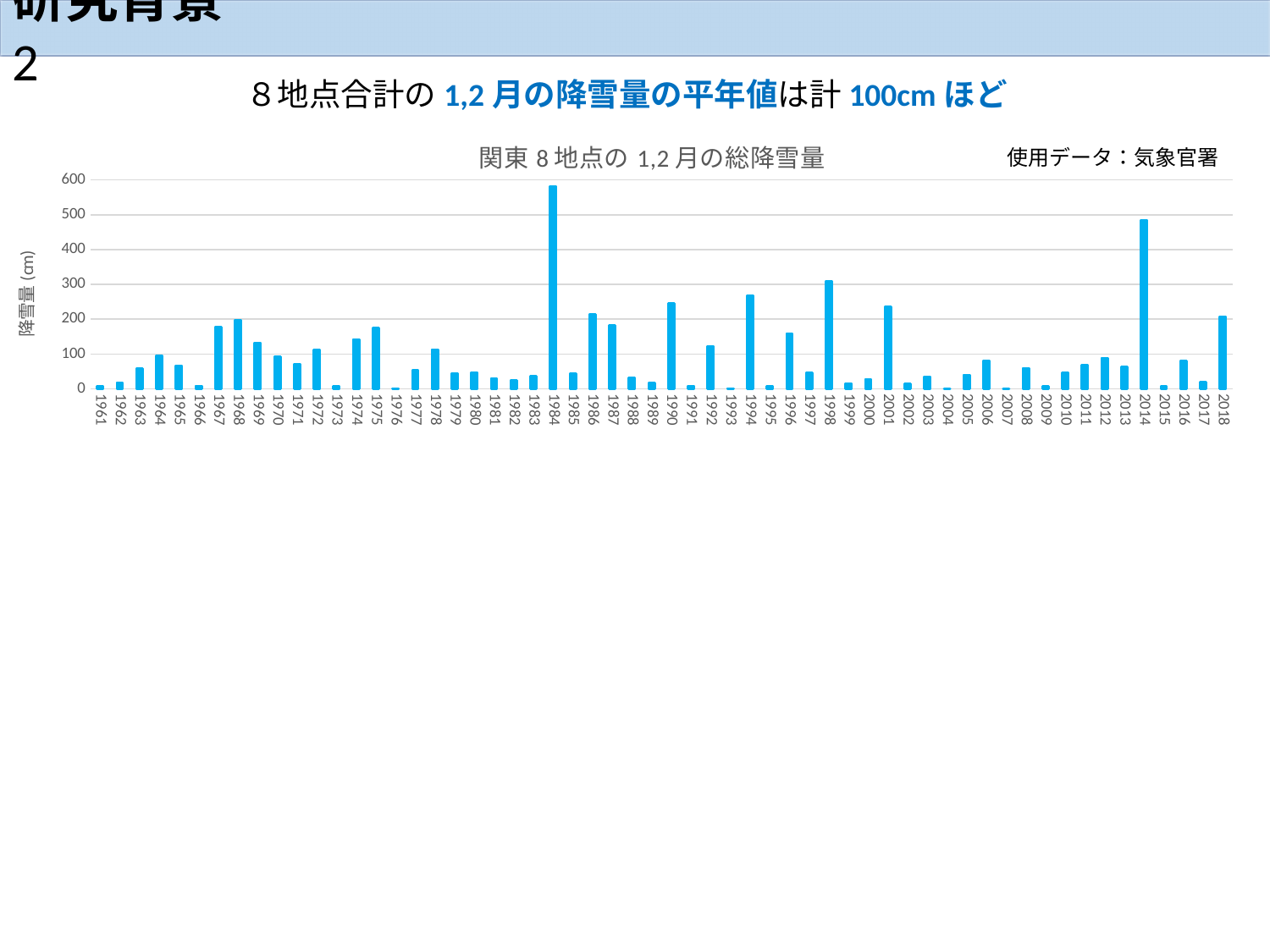
Is the value for 1994 greater or less than 200? greater Which year has the larger value, 1984 or 2014? 1984 Is the value for 1976 greater or less than 100? less Is the value for 1984 greater or less than 500? greater How many years (bars) are plotted in the chart? 58 What is the label of the vertical axis? 降雪量 (cm) Which year has the highest total snowfall in the chart? 1984 Which year has the larger value, 1990 or 1992? 1990 What kind of chart is shown on the slide? bar chart